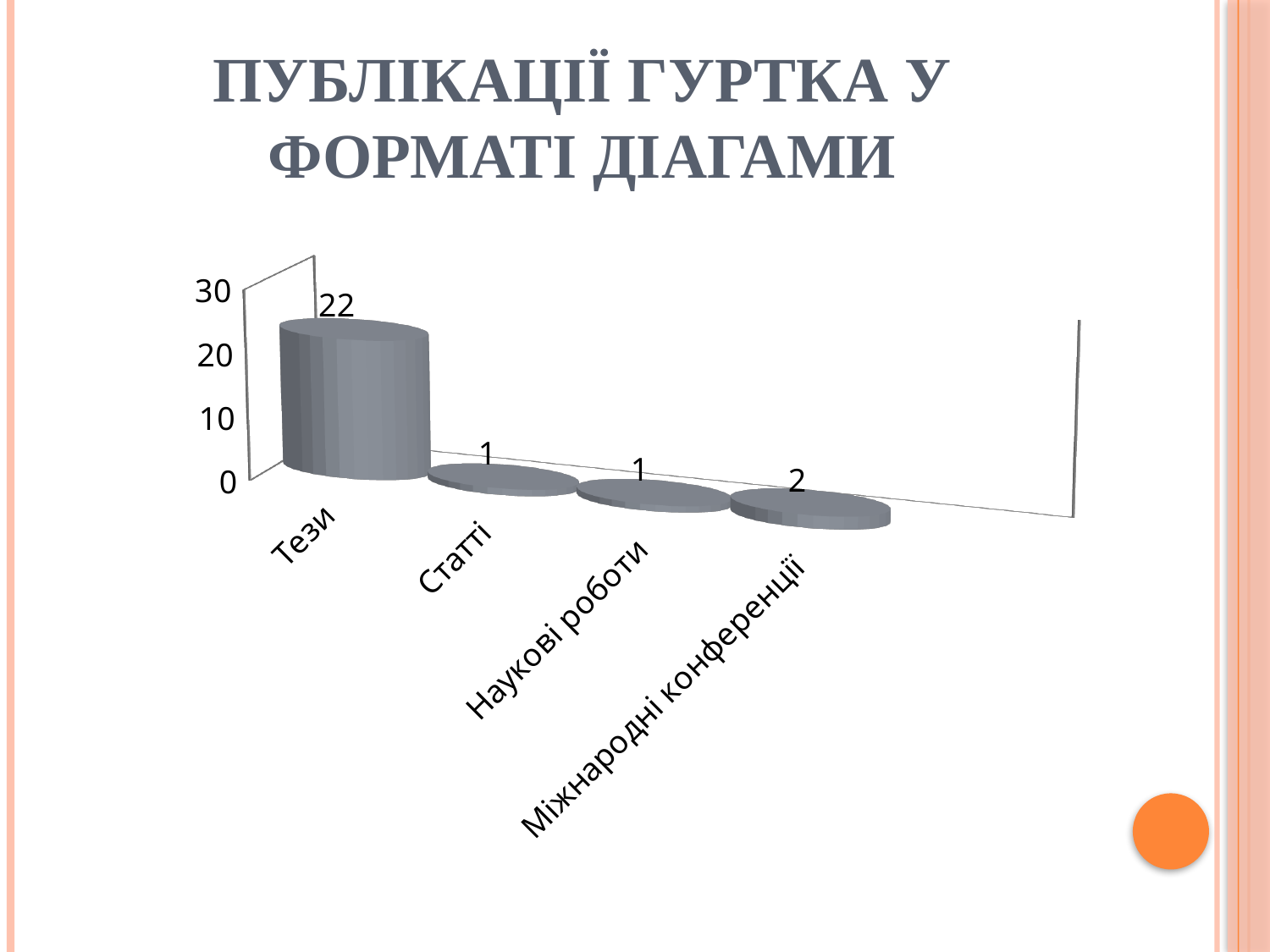
How many categories are shown on the x axis? 4 What kind of chart is shown on the slide? bar chart What is the difference between the values for Тези and Міжнародні конференції? 20 What is the value for Статті? 1 What is the value for Міжнародні конференції? 2 What is the value for Тези? 22 Which is larger, the value for Міжнародні конференції or the value for Статті? Міжнародні конференції Is the value for Тези greater or less than 20? greater What is the highest tick value shown on the vertical axis? 30 Which category has the highest value? Тези What is the value for Наукові роботи? 1 What is the title of the slide containing the chart? ПУБЛІКАЦІЇ ГУРТКА У ФОРМАТІ ДІАГАМИ